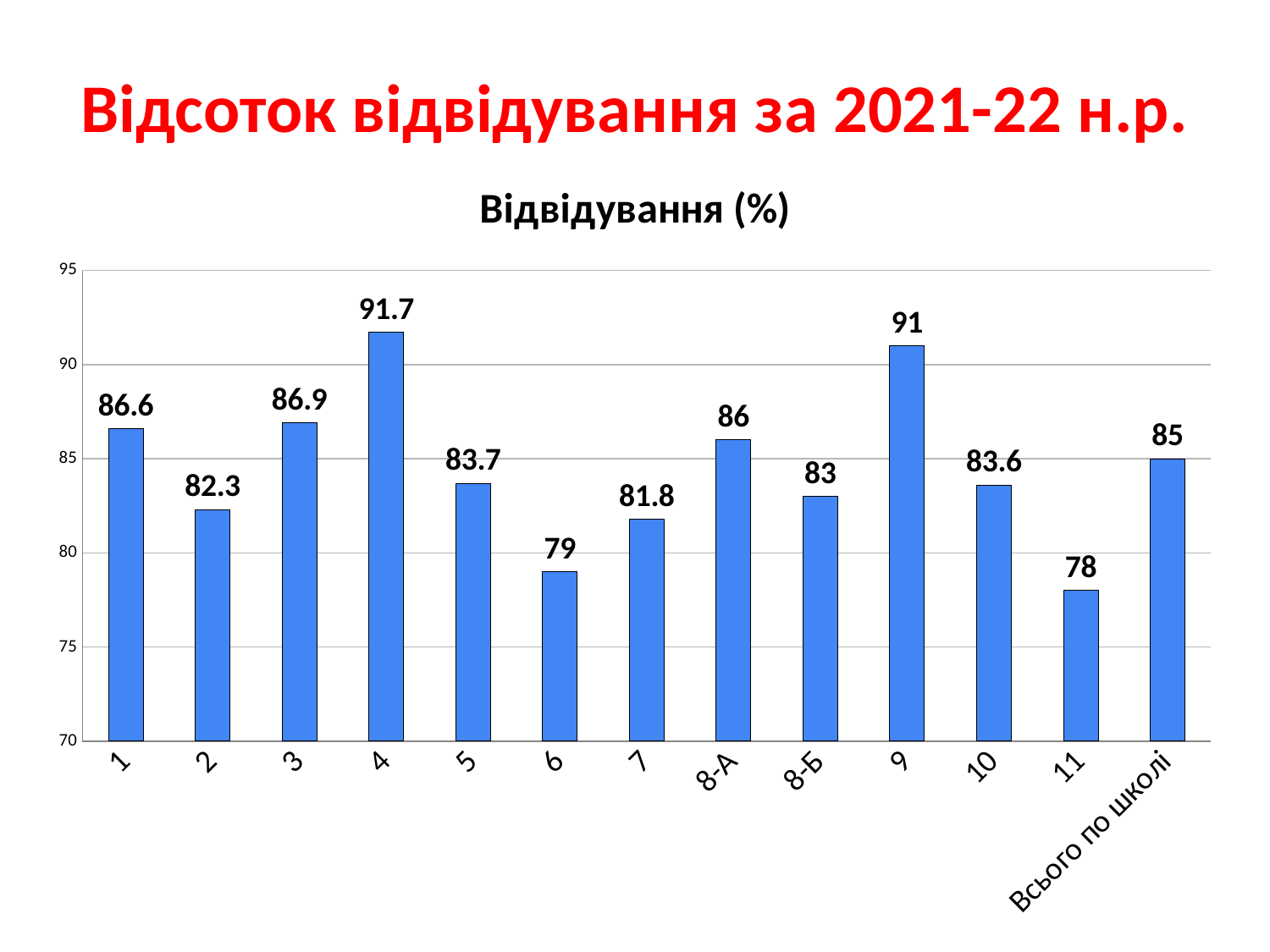
Is the value for class 7 greater or less than 85? less What is the difference between the attendance values for class 9 and class 6? 12 Which category has the lowest attendance value? 11 What is the difference between the attendance values for class 4 and class 11? 13.7 Which has a higher attendance value, class 3 or class 1? 3 What is the title of the chart? Відвідування (%) What is the attendance value for 'Всього по школі'? 85 How many categories are shown on the x axis? 13 What kind of chart is shown on the slide? bar chart What is the attendance value for class 8-Б? 83 Which category has the highest attendance value? 4 What is the attendance value for class 4? 91.7